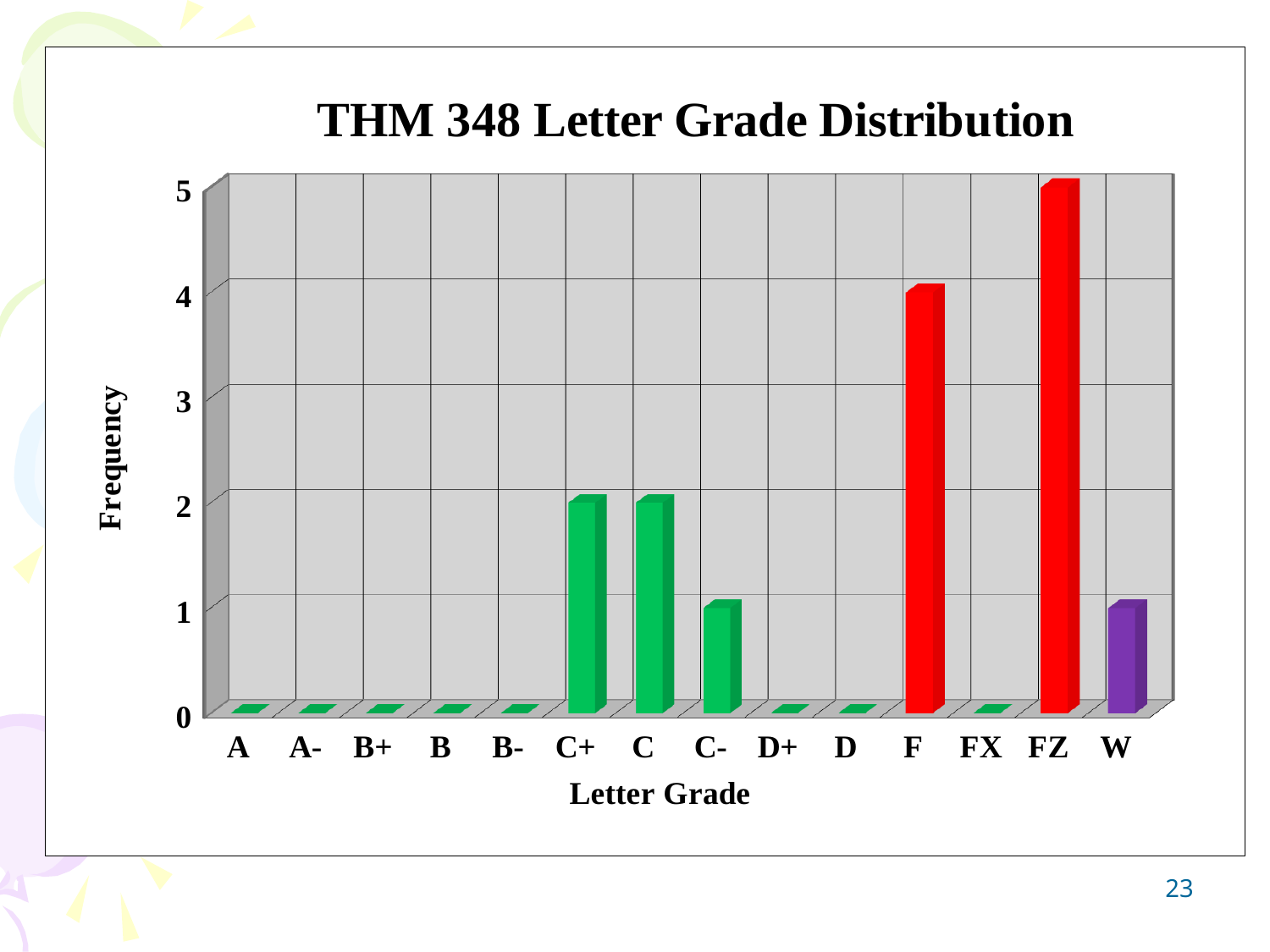
What is the difference in frequency between FZ and F? 1 What is the frequency for letter grade W? 1 Which has a higher frequency, F or C+? F Which letter grade has the highest frequency? FZ What is the difference in frequency between C and C-? 1 What is the title of the chart? THM 348 Letter Grade Distribution Is the frequency for F greater or less than 3? greater What kind of chart is shown on the slide? bar chart What is the frequency for letter grade FZ? 5 How many letter grade categories are shown on the x axis? 14 What is the frequency for letter grade C+? 2 What is the frequency for letter grade F? 4